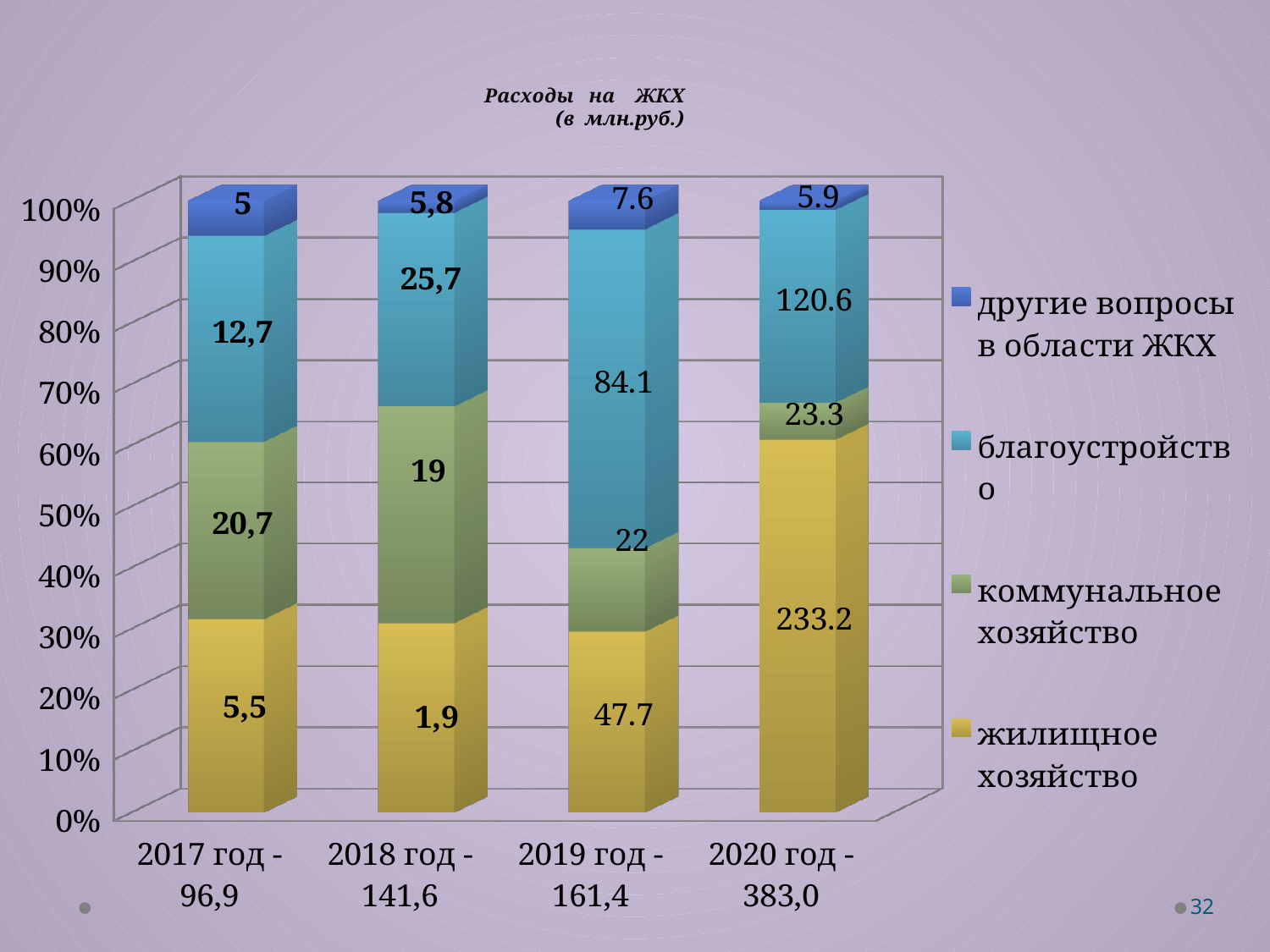
How many series does the legend list? 4 What is the value for благоустройство in 2019 год? 84.1 What is the value for коммунальное хозяйство in 2017 год? 20,7 What is the difference between the благоустройство values for 2020 год and 2019 год? 36.5 What is the title of the chart? Расходы на ЖКХ (в млн.руб.) How many years (categories) are shown on the x axis? 4 In which year is the value for жилищное хозяйство the lowest? 2018 год What is the value for другие вопросы в области ЖКХ in 2018 год? 5,8 What is the value for жилищное хозяйство in 2020 год? 233.2 What kind of chart is shown on the slide? Stacked bar chart Which year has the larger value for коммунальное хозяйство, 2019 год or 2020 год? 2020 год In which year is the value for жилищное хозяйство the highest? 2020 год